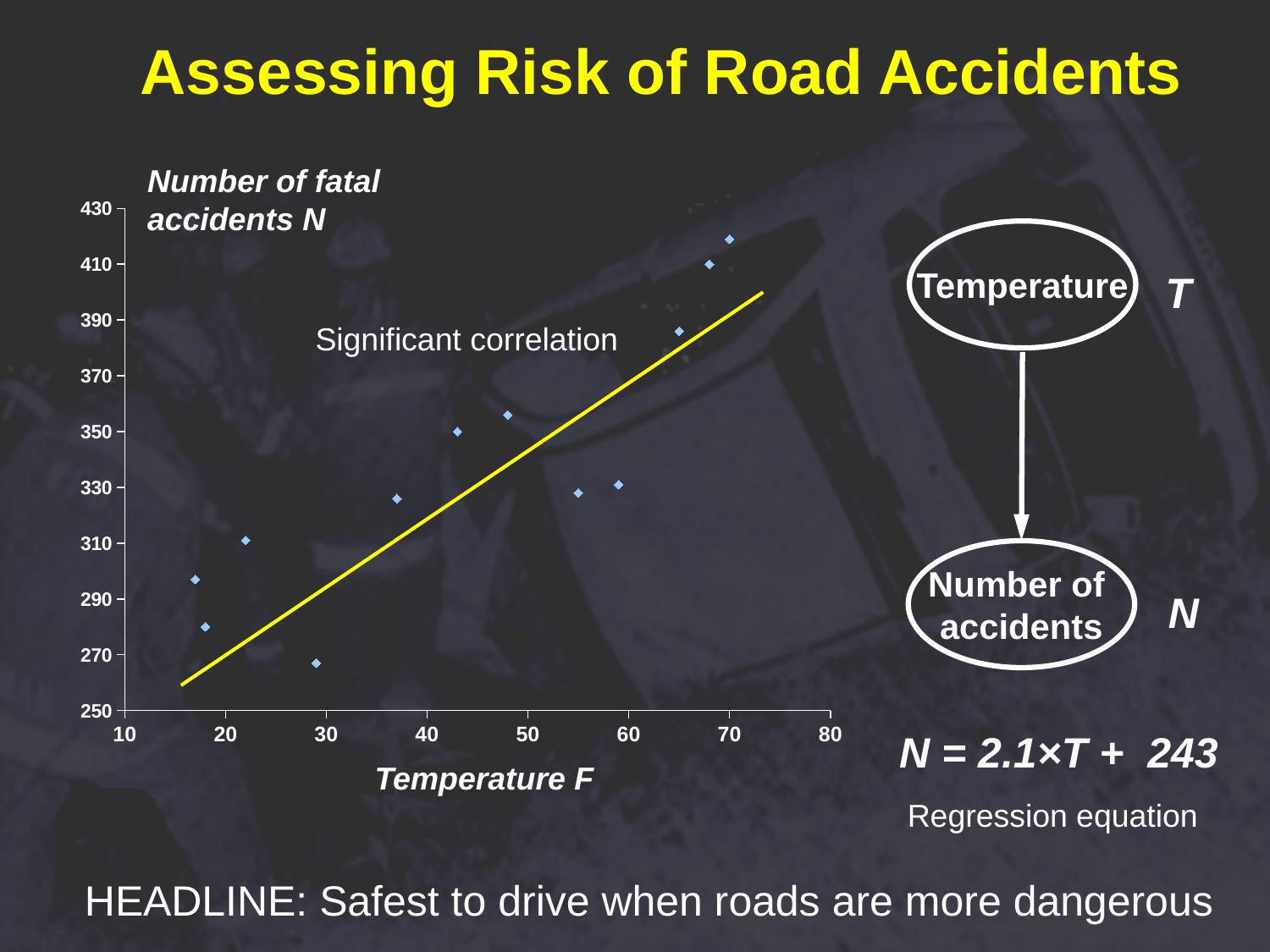
Is the value for the point at about 18 F greater or less than 290? less What regression equation is shown next to the chart? N = 2.1×T + 243 As temperature increases along the x axis, do the number of fatal accidents generally rise or fall? rise Is the value for the point at about 37 F greater or less than 310? greater What is the label of the x axis of the chart? Temperature F What kind of chart is shown on the slide? scatter plot Is the value for the point at about 70 F greater or less than 410? greater How many data points are plotted on the scatter chart? 12